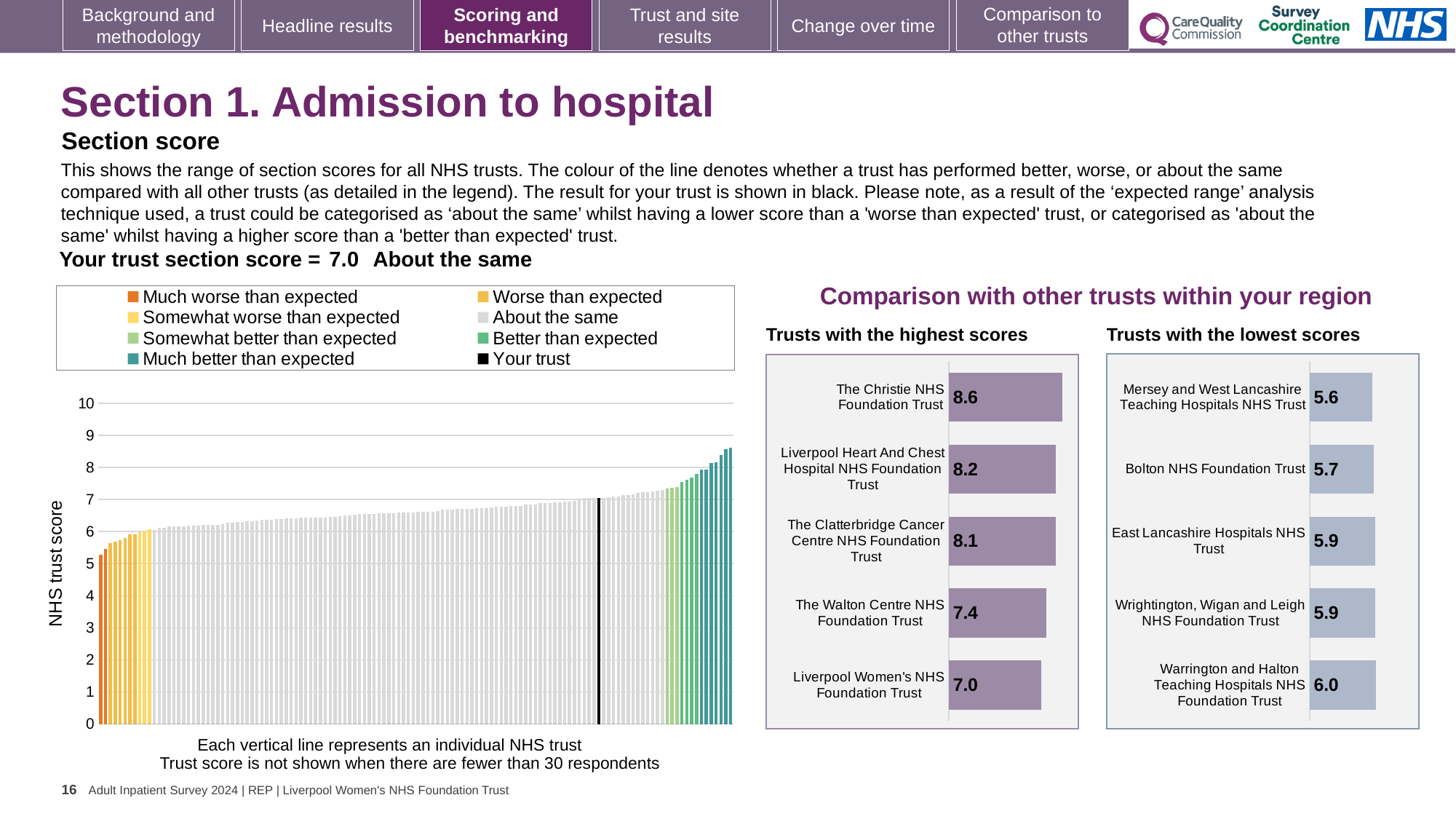
In the 'Trusts with the highest scores' chart, how many trusts are shown? 5 In the main NHS trust score chart on the left, what colour is the bar for your trust? Black In the 'Trusts with the lowest scores' chart, which trust has the lowest score? Mersey and West Lancashire Teaching Hospitals NHS Trust In the main NHS trust score chart on the left, how many entries does the legend list? 8 In the 'Trusts with the highest scores' chart, what is the difference between the scores of The Christie NHS Foundation Trust and Liverpool Women's NHS Foundation Trust? 1.6 In the 'Trusts with the highest scores' chart, which trust has the highest score? The Christie NHS Foundation Trust In the main NHS trust score chart on the left, what is the section score for your trust? 7.0 In the main NHS trust score chart on the left, do the trust scores rise or fall from left to right? Rise In the 'Trusts with the highest scores' chart, what is the score for The Christie NHS Foundation Trust? 8.6 In the 'Trusts with the lowest scores' chart, which has the larger score: Warrington and Halton Teaching Hospitals NHS Foundation Trust or Mersey and West Lancashire Teaching Hospitals NHS Trust? Warrington and Halton Teaching Hospitals NHS Foundation Trust What kind of chart is the main NHS trust score chart on the left? Bar chart In the 'Trusts with the lowest scores' chart, what is the score for Bolton NHS Foundation Trust? 5.7